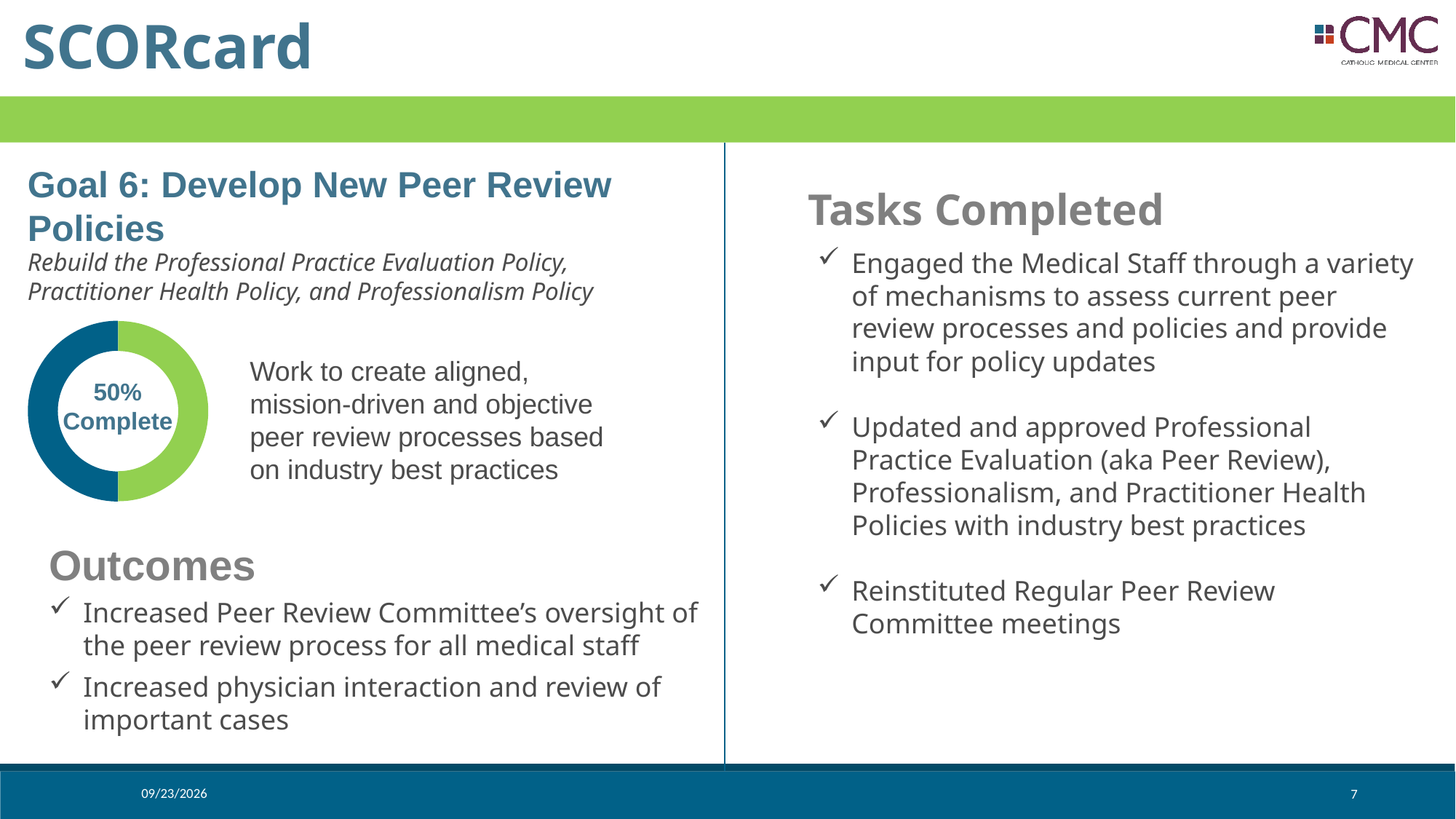
What kind of chart is shown on the slide? Donut chart What percentage complete does the donut chart show? 50% What share of the donut chart remains incomplete? 50% Which goal does the donut chart track progress for? Goal 6: Develop New Peer Review Policies What share of the donut chart does the completed portion represent? 50% How many segments does the donut chart have? 2 What text is printed in the centre of the donut chart? 50% Complete